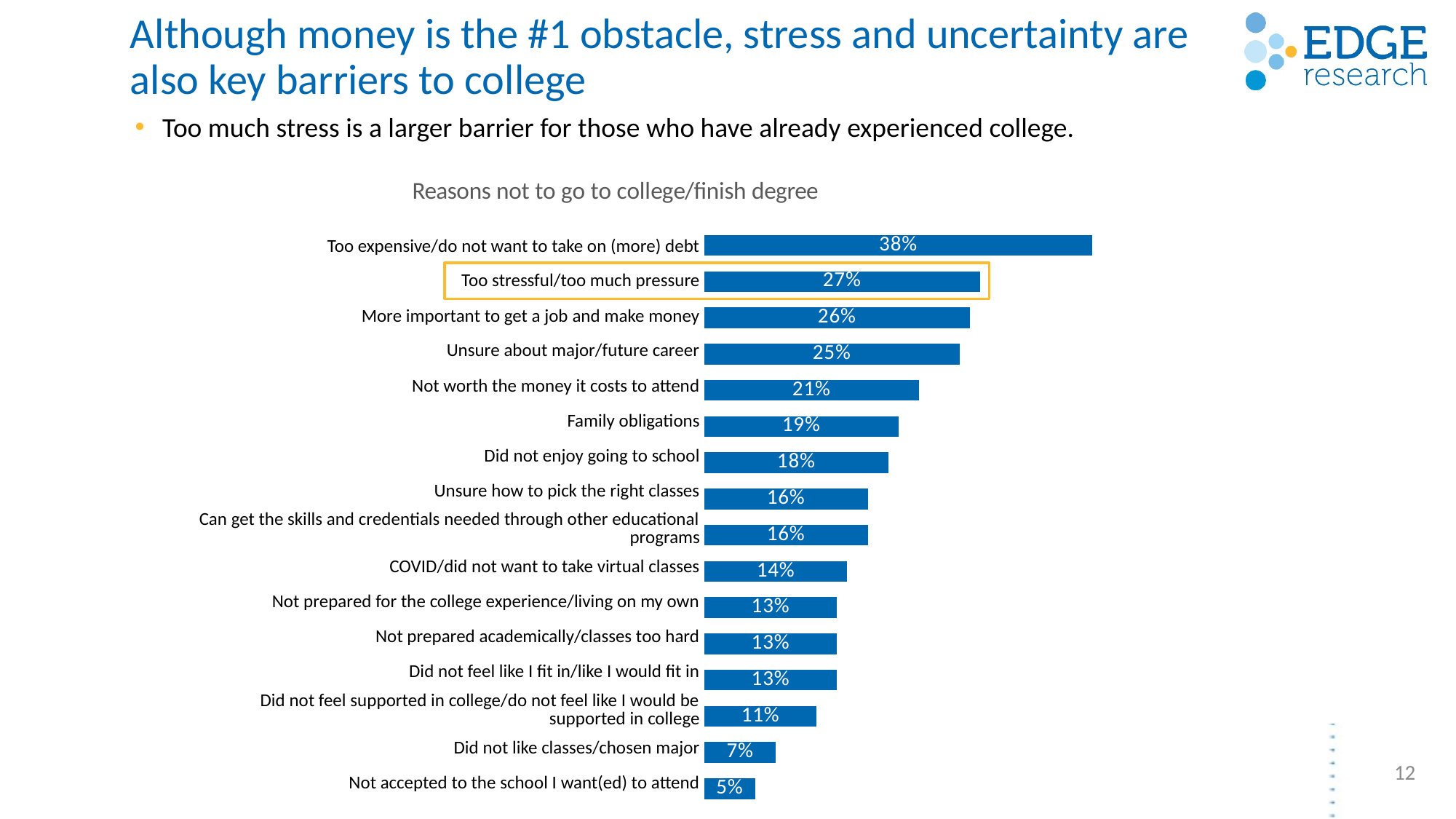
What is the value for "COVID/did not want to take virtual classes"? 14% What type of chart is shown on the slide? Bar chart What is the value for "Too stressful/too much pressure"? 27% What percentage cited "Too expensive/do not want to take on (more) debt" as a reason not to go to college/finish degree? 38% How many reasons are listed in the chart? 16 What percentage is shown for "Family obligations"? 19% Which reason has the lowest percentage? Not accepted to the school I want(ed) to attend What is the difference between "Too expensive/do not want to take on (more) debt" and "Too stressful/too much pressure"? 11 percentage points What is the title of the chart? Reasons not to go to college/finish degree Which bar is highlighted with an orange outline? Too stressful/too much pressure Which reason has the highest percentage? Too expensive/do not want to take on (more) debt Which is larger: "Unsure about major/future career" or "Not worth the money it costs to attend"? Unsure about major/future career